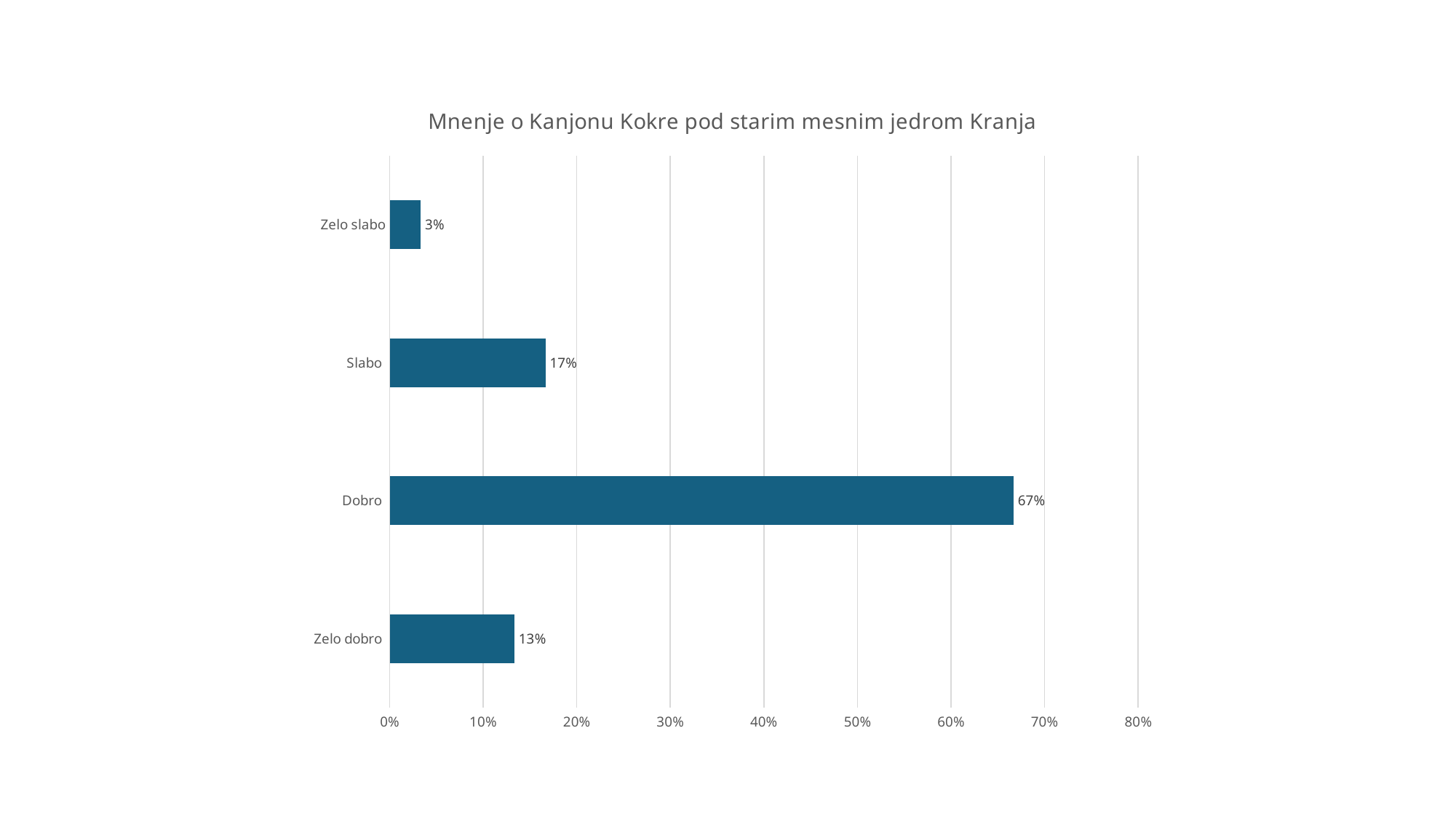
What is the title of the chart? Mnenje o Kanjonu Kokre pod starim mesnim jedrom Kranja Is the value for Dobro greater or less than 60%? greater What is the value for Zelo slabo? 3% What is the difference between the values for Dobro and Slabo? 50% How many categories are shown in the chart? 4 Which category has the lowest value? Zelo slabo Which is larger, the value for Slabo or the value for Zelo dobro? Slabo What is the value for Zelo dobro? 13% What is the value for Dobro? 67% What is the value for Slabo? 17% Which category has the highest value? Dobro What kind of chart is shown on the slide? bar chart